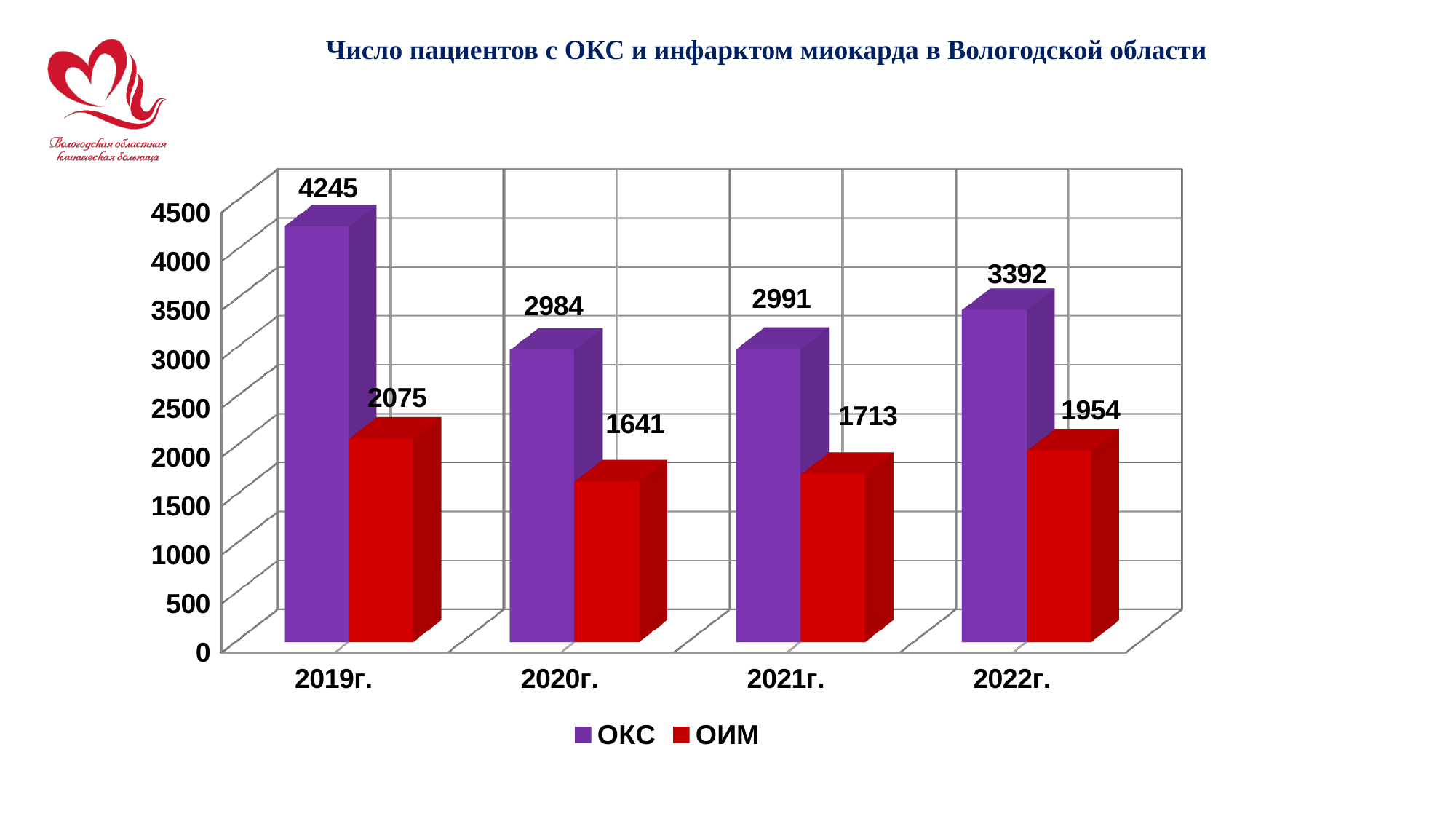
How many series does the legend list? 2 What is the value for ОИМ in 2020г.? 1641 Which year has the lowest value for ОИМ? 2020г. Which is larger: the ОИМ value in 2022г. or the ОИМ value in 2019г.? 2019г. How many years are shown on the x axis? 4 What is the difference between the ОКС and ОИМ values in 2019г.? 2170 What kind of chart is shown on the slide? bar chart What is the value for ОИМ in 2021г.? 1713 Which year has the highest value for ОКС? 2019г. What is the value for ОКС in 2019г.? 4245 What is the value for ОКС in 2022г.? 3392 Which colour represents the ОИМ series? red